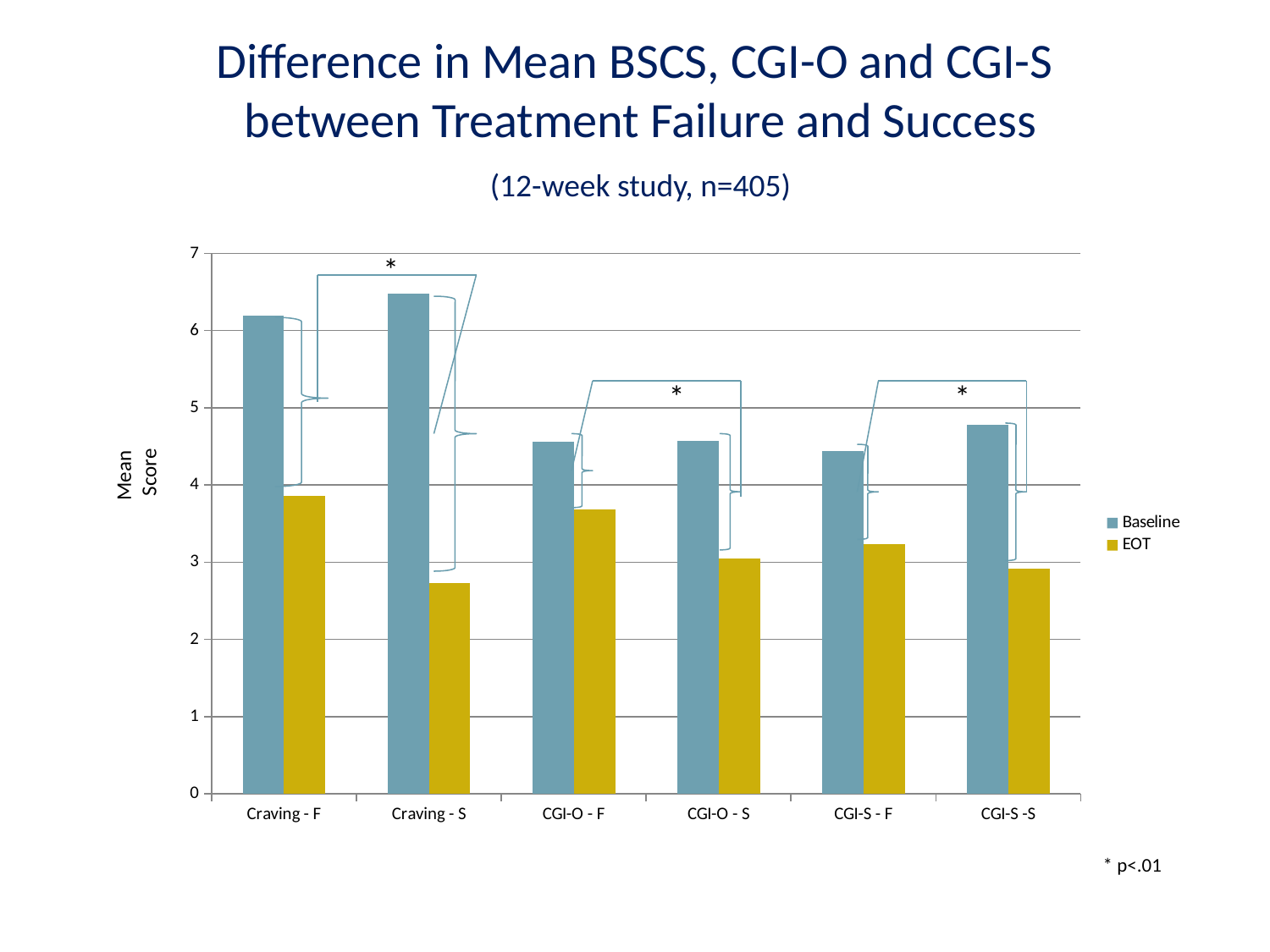
Is the EOT value for CGI-O - F greater or less than 3? greater Which is larger, the EOT value for Craving - F or the EOT value for CGI-S -S? Craving - F What is the label on the y axis? Mean Score Which category has the lowest EOT value? Craving - S Which is larger, the Baseline value for Craving - S or the Baseline value for CGI-O - S? Craving - S How many series does the legend list? 2 What kind of chart is shown on the slide? bar chart Which category has the highest Baseline value? Craving - S Is the Baseline value for CGI-S - F greater or less than 5? less Is the Baseline value for Craving - F greater or less than 6? greater How many categories are shown along the x axis? 6